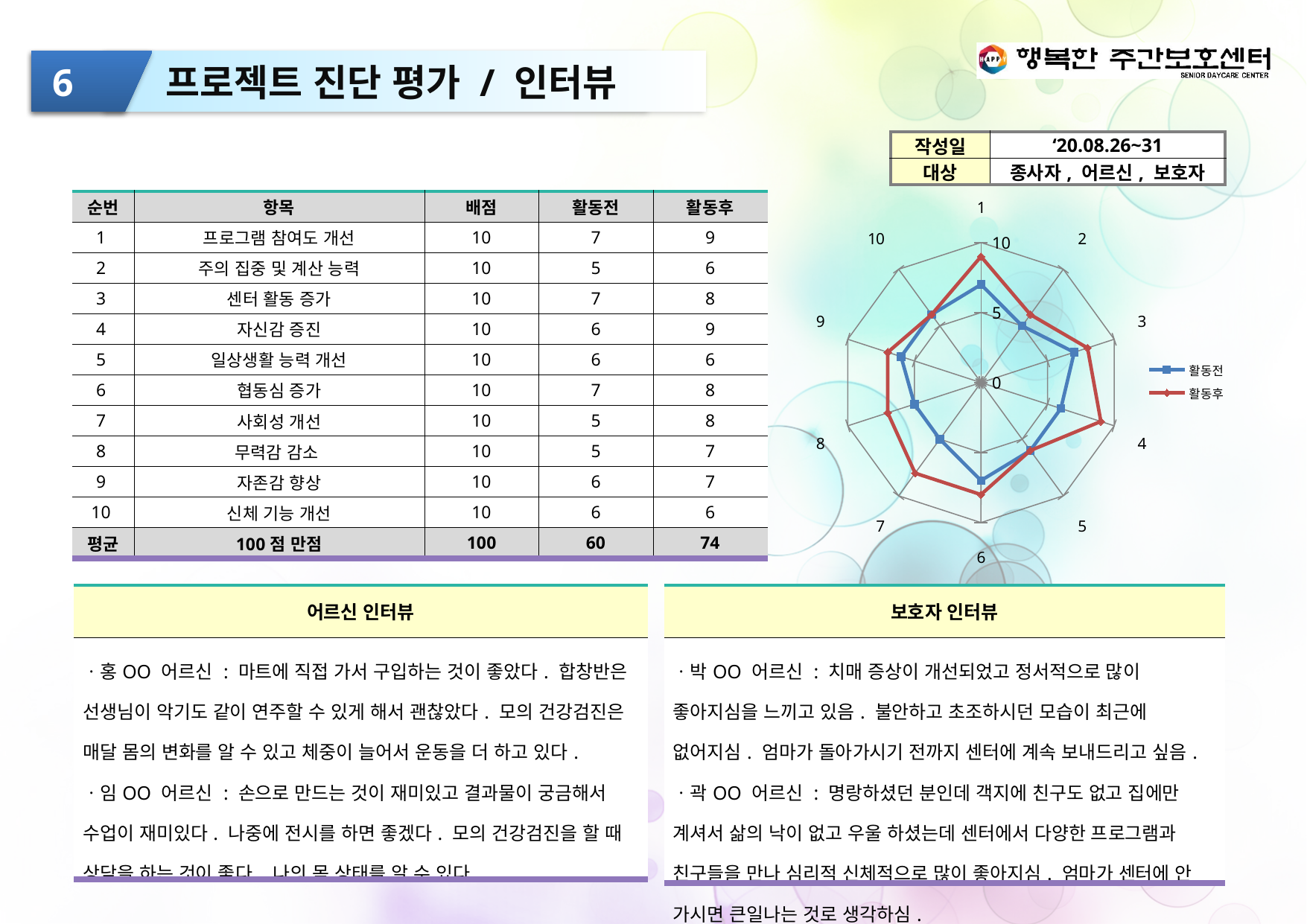
Which colour is used for the 활동후 series in the radar chart? Red In the radar chart, is the 활동후 value for category 3 greater or less than 5? greater In the radar chart, which series has the larger value for category 4, 활동전 or 활동후? 활동후 In the radar chart, is the 활동후 value for category 4 greater or less than 5? greater In the radar chart, which series has the larger value for category 7, 활동전 or 활동후? 활동후 In the radar chart, is the 활동전 value for category 1 greater or less than 5? greater What kind of chart is shown on the right side of the slide? Radar chart How many categories (axes) does the radar chart have? 10 What are the two series named in the radar chart legend? 활동전, 활동후 How many series does the legend of the radar chart list? 2